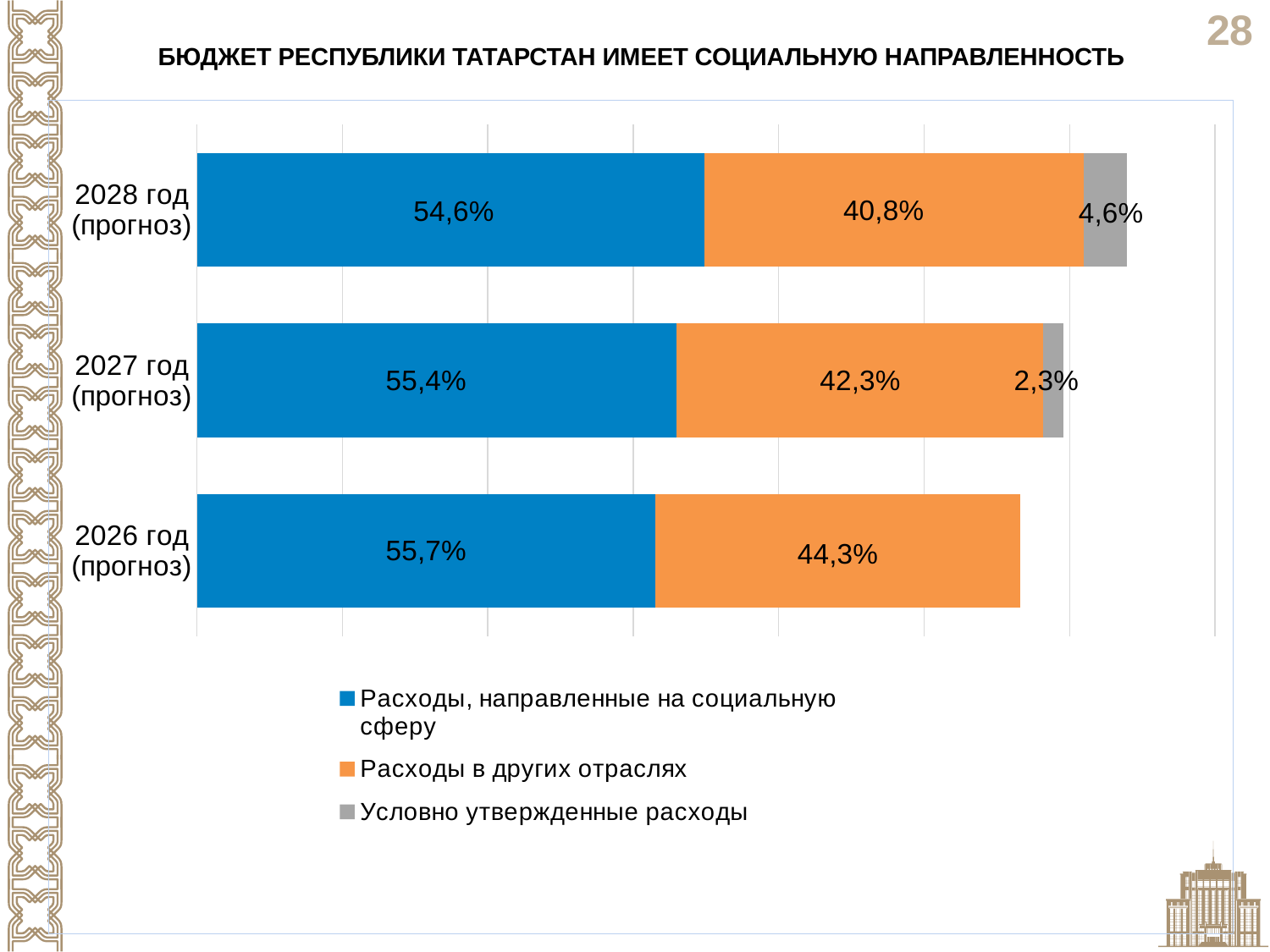
In which year is the share of 'Расходы в других отраслях' the lowest? 2028 год (прогноз) In which year is the share of 'Расходы, направленные на социальную сферу' the highest? 2026 год (прогноз) How many year categories are shown on the chart? 3 How many series does the legend list? 3 What is the value for 'Расходы в других отраслях' in 2026 год (прогноз)? 44,3% Which colour represents 'Расходы в других отраслях' in the chart? Orange What is the value for 'Условно утвержденные расходы' in 2027 год (прогноз)? 2,3% What is the value for 'Расходы, направленные на социальную сферу' in 2028 год (прогноз)? 54,6% Which is larger: 'Условно утвержденные расходы' in 2028 год (прогноз) or in 2027 год (прогноз)? 2028 год (прогноз) What is the total of the stacked bar for 2027 год (прогноз)? 100% What is the difference between 'Расходы в других отраслях' in 2026 год (прогноз) and in 2028 год (прогноз)? 3,5 percentage points What kind of chart is shown on the slide? Stacked bar chart